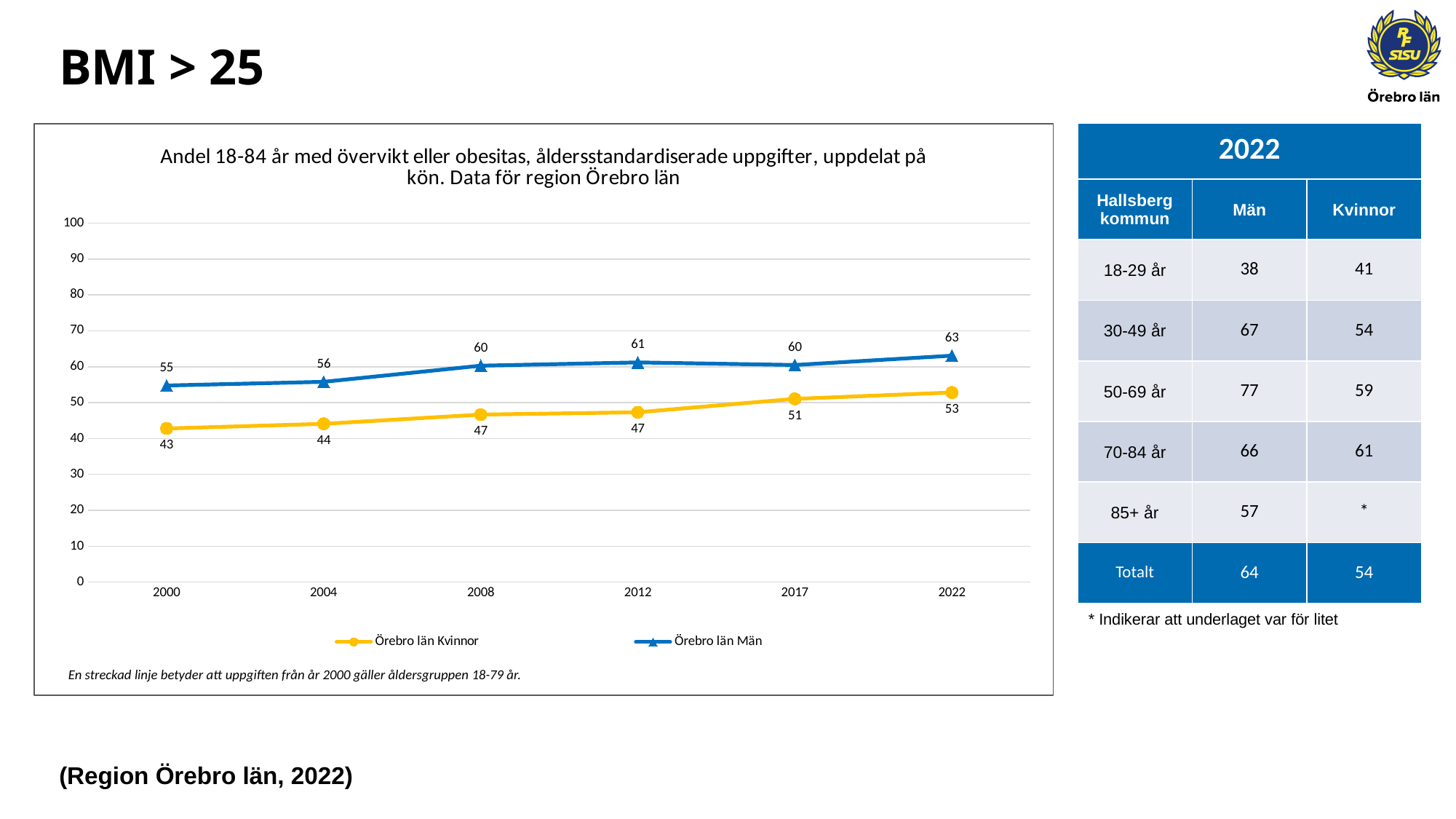
What kind of chart is shown on the slide? line chart What is the value for Örebro län Män in 2022? 63 In which year is the value for Örebro län Kvinnor lowest? 2000 Does the value for Örebro län Kvinnor rise or fall from 2000 to 2022? rise Which series has the larger value in 2012, Örebro län Kvinnor or Örebro län Män? Örebro län Män How many series does the chart legend list? 2 In which year is the value for Örebro län Män highest? 2022 What is the value for Örebro län Kvinnor in 2017? 51 How many years are shown on the x axis of the chart? 6 What is the value for Örebro län Kvinnor in 2000? 43 What is the difference between Örebro län Män and Örebro län Kvinnor in 2008? 13 Is the value for Örebro län Kvinnor in 2004 greater or less than 50? less